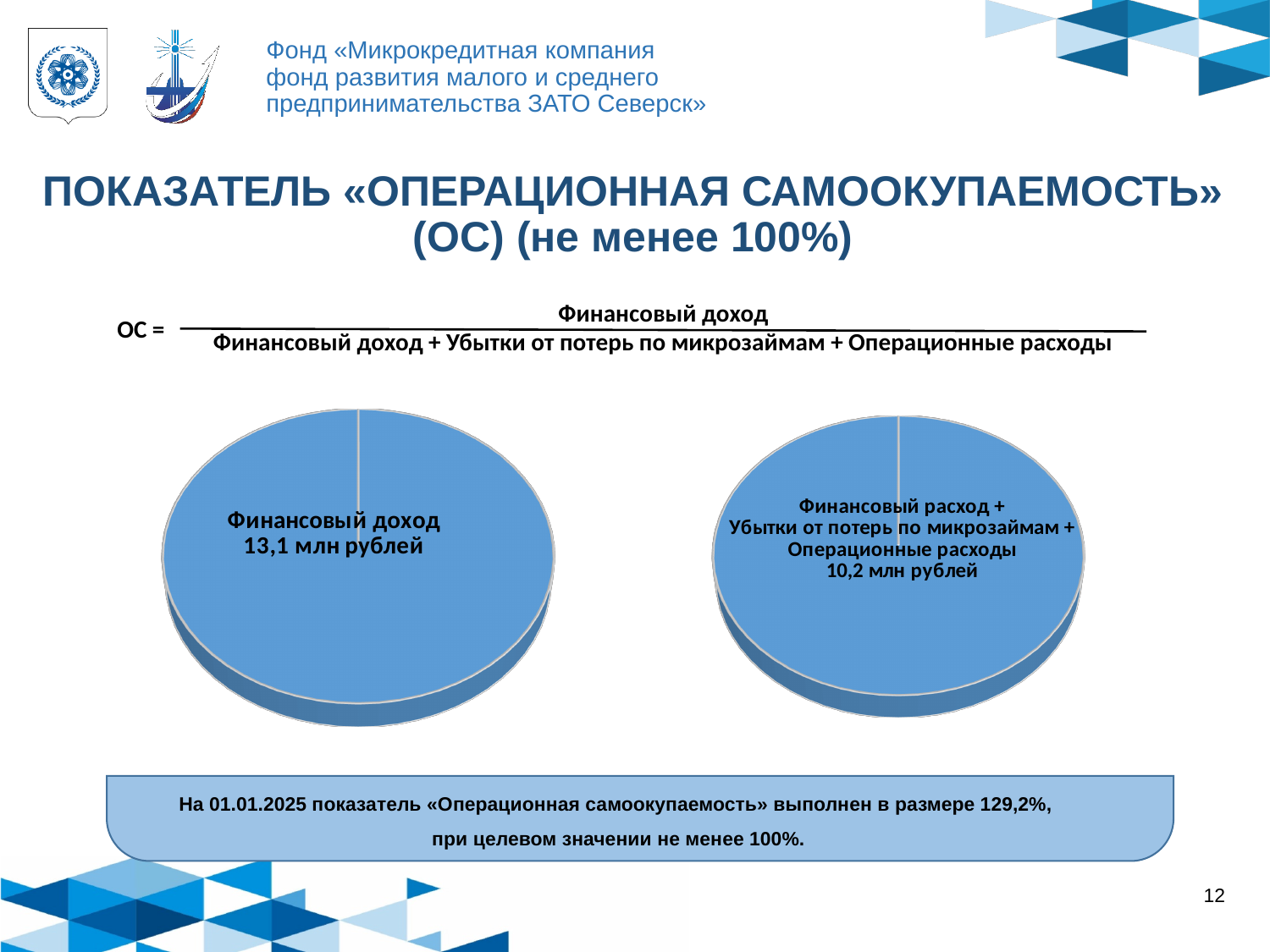
На сколько финансовый доход (левая диаграмма) превышает сумму расходов (правая диаграмма)? 2,9 млн рублей Какого типа диаграмма расположена справа на слайде? Круговая диаграмма Какое значение показано на левой круговой диаграмме для категории «Финансовый доход»? 13,1 млн рублей Какого типа диаграмма расположена слева на слайде? Круговая диаграмма Сколько секторов содержит левая круговая диаграмма? 1 Какое значение показано на правой круговой диаграмме для категории «Финансовый расход + Убытки от потерь по микрозаймам + Операционные расходы»? 10,2 млн рублей Сколько секторов содержит правая круговая диаграмма? 1 Какую долю левой круговой диаграммы занимает сектор «Финансовый доход»? 100% Сколько круговых диаграмм изображено на слайде? 2 Какого цвета сектор на правой круговой диаграмме? Синий Какое значение больше: финансовый доход на левой диаграмме или сумма расходов на правой диаграмме? Финансовый доход (13,1 млн рублей)